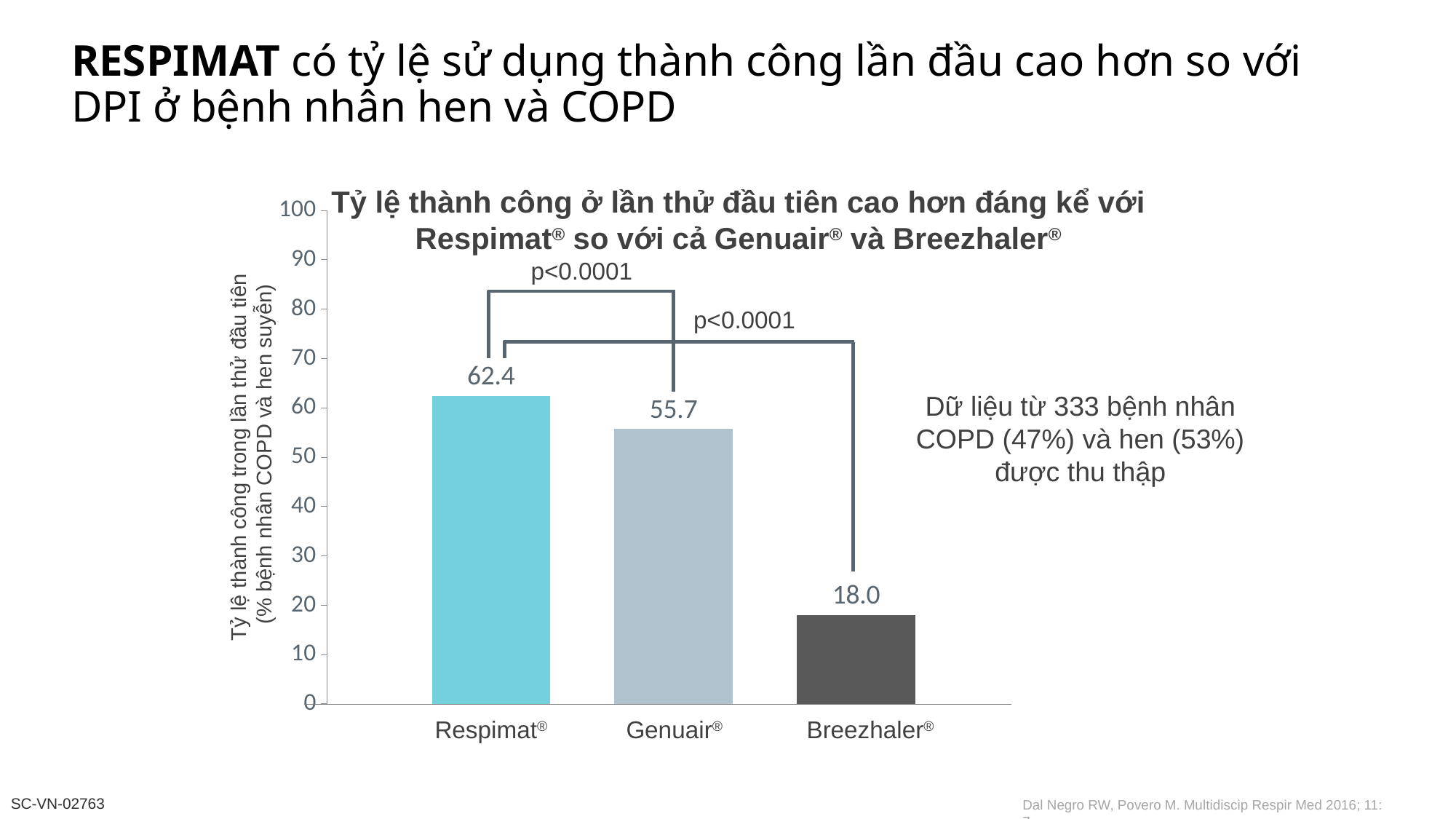
Which has a higher success rate, Genuair or Breezhaler? Genuair What p-value is shown for the comparison between Respimat and Genuair? p<0.0001 What kind of chart is shown on the slide? Bar chart What is the first-attempt success rate shown for Respimat? 62.4 What is the first-attempt success rate shown for Breezhaler? 18.0 What is the difference between the success rates of Respimat and Genuair? 6.7 How many inhalers are compared in the chart? 3 What is the first-attempt success rate shown for Genuair? 55.7 Which inhaler has the highest first-attempt success rate? Respimat What is the difference between the success rates of Genuair and Breezhaler? 37.7 Is the value for Breezhaler greater or less than 20? less Which inhaler has the lowest first-attempt success rate? Breezhaler